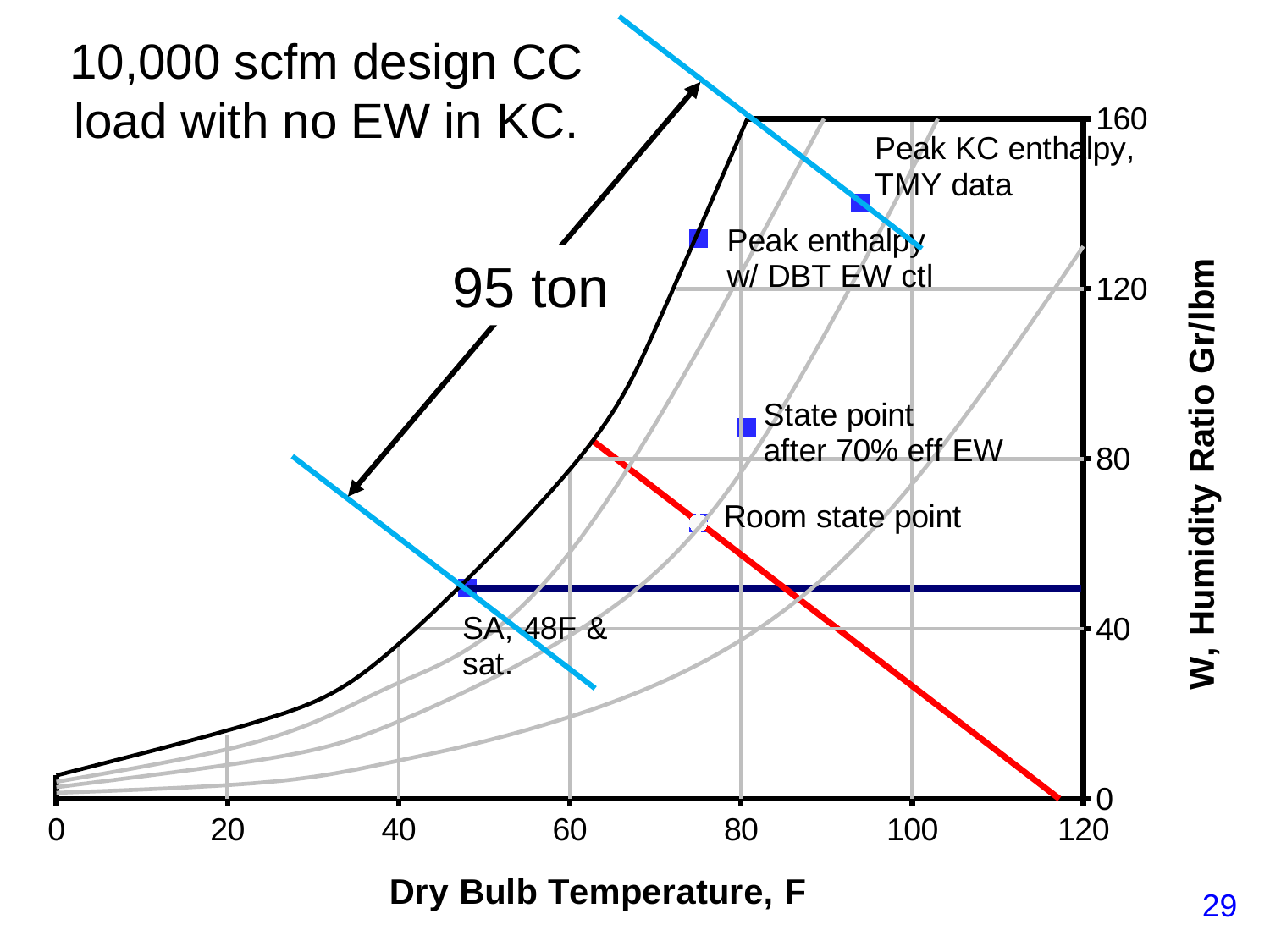
What is the highest value shown on the y axis? 160 How many labeled state points are marked on the chart? 5 Is the humidity ratio of the 'Room state point' greater or less than 80? less Is the humidity ratio of the 'Peak KC enthalpy, TMY data' point greater or less than 120? greater What is the x-axis title of the chart? Dry Bulb Temperature, F What dry bulb temperature is given in the label for the supply air (SA) point? 48F Which point has the higher humidity ratio, 'Peak KC enthalpy, TMY data' or 'Room state point'? Peak KC enthalpy, TMY data Which point has the higher dry bulb temperature, 'Peak KC enthalpy, TMY data' or 'Peak enthalpy w/ DBT EW ctl'? Peak KC enthalpy, TMY data Is the humidity ratio of the 'SA, 48F & sat.' point greater or less than 40? greater What is the y-axis title of the chart? W, Humidity Ratio Gr/lbm